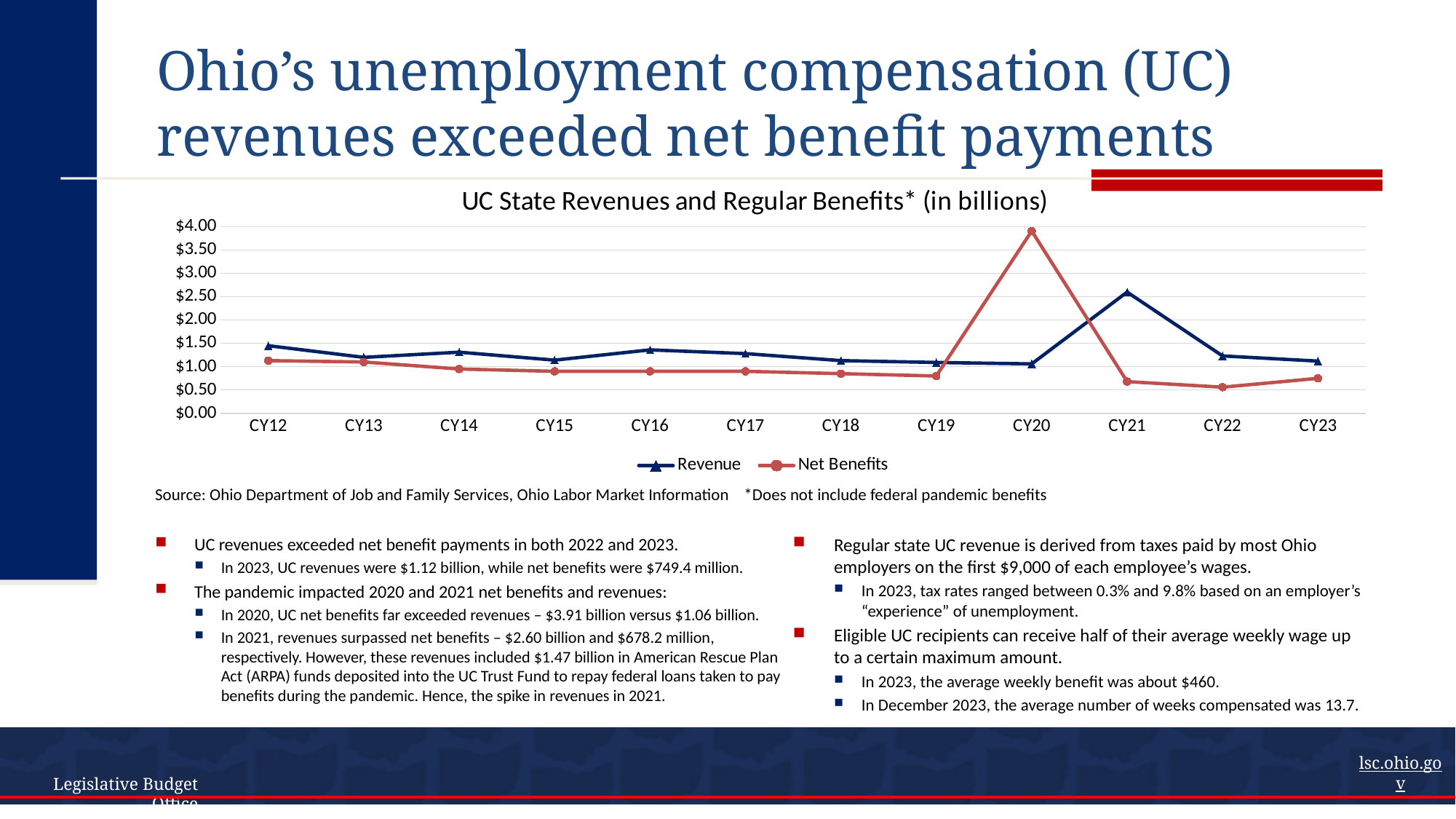
Is the Net Benefits value for CY20 greater or less than $3.50? greater What is the title of the chart? UC State Revenues and Regular Benefits* (in billions) Is the Revenue value for CY21 greater or less than $2.00? greater Is the Net Benefits value for CY22 greater or less than $1.00? less What kind of chart is shown on the slide? line chart In CY20, which series has the larger value, Revenue or Net Benefits? Net Benefits In which year does the Net Benefits line reach its highest value? CY20 How many series does the chart legend list? 2 How many years are plotted along the x axis of the chart? 12 In which year is the Net Benefits value lowest? CY22 In CY21, which series has the larger value, Revenue or Net Benefits? Revenue In which year does the Revenue line reach its highest value? CY21